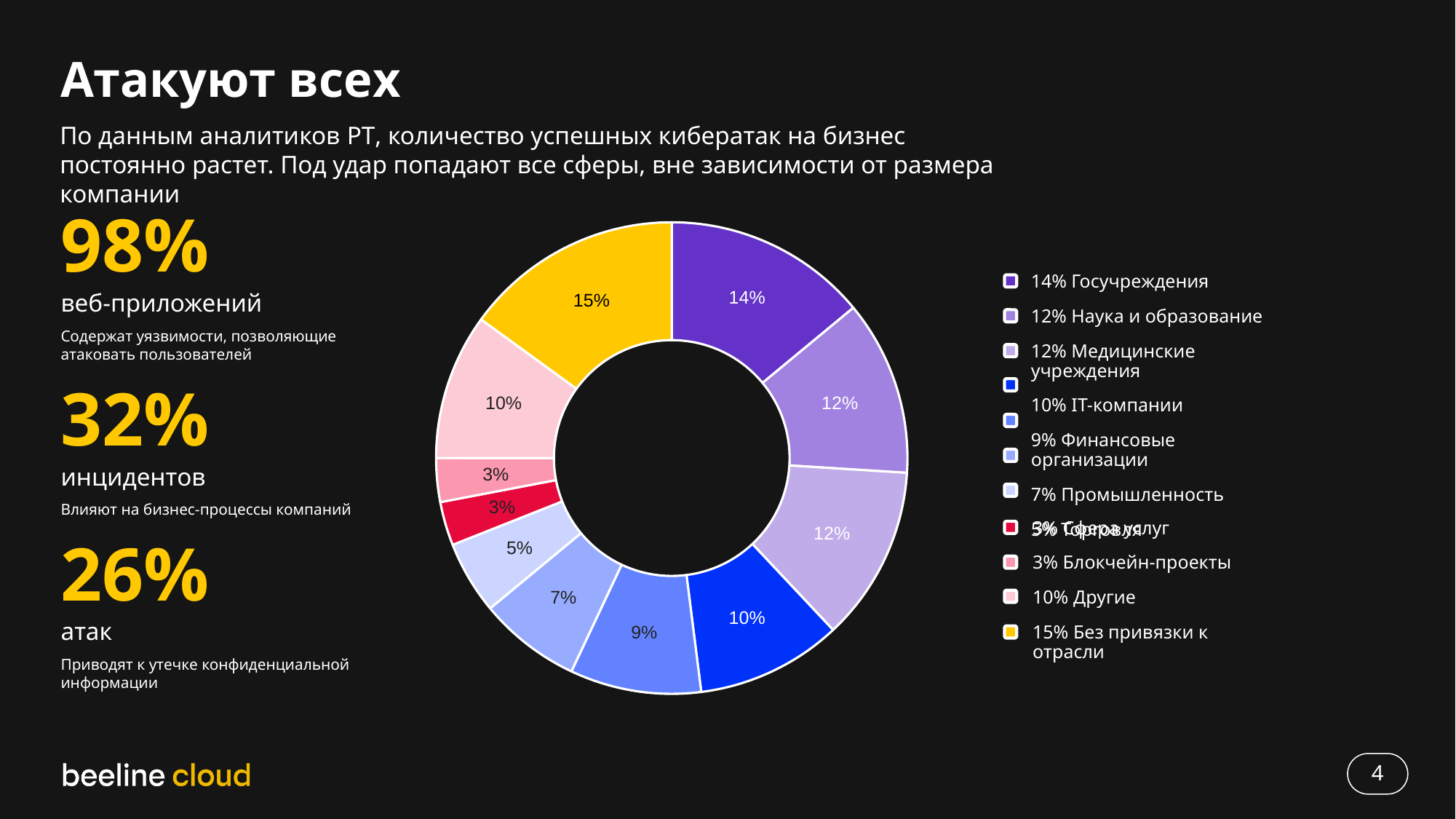
What is the value for IT-компании? 10% Which category has the largest slice of the chart? Без привязки к отрасли What is the difference between the values for Госучреждения and IT-компании? 4% How many slices does the chart have? 11 What share of the chart does Госучреждения account for? 14% What is the value for Без привязки к отрасли? 15% What is the value for Промышленность? 7% What is the value for Блокчейн-проекты? 3% What colour is the slice for Без привязки к отрасли? Yellow What kind of chart is shown on the slide? Donut (pie) chart What is the value for Финансовые организации? 9% Which is larger, the value for Госучреждения or the value for Наука и образование? Госучреждения